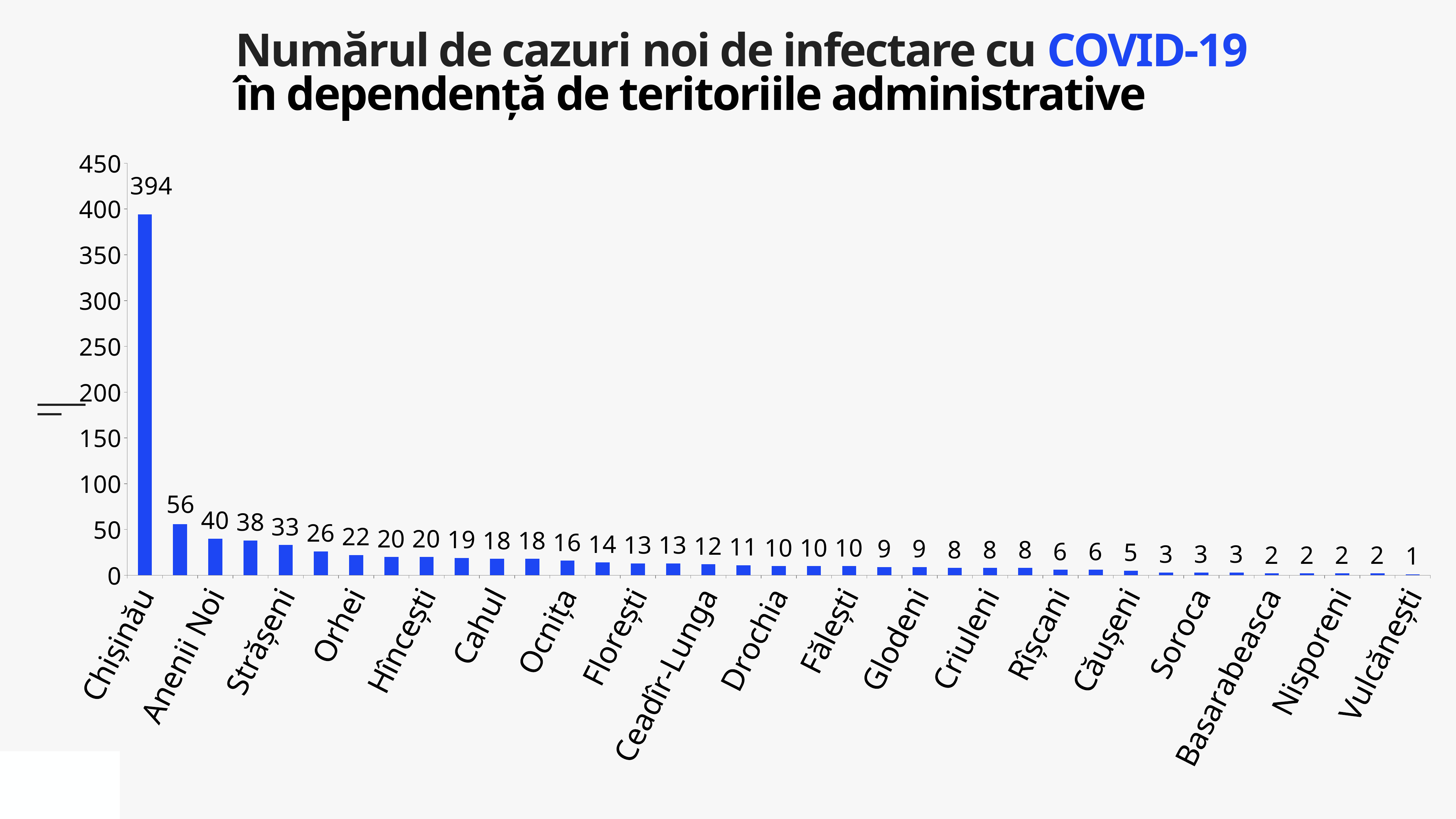
What is the difference between the values for Chișinău and Anenii Noi? 354 How many new cases are shown for Orhei? 22 Which territory has the lowest number of new cases? Vulcănești Is the value for Chișinău greater or less than 350? greater What colour are the bars in the chart? blue Which has more new cases, Orhei or Cahul? Orhei What type of chart is shown on the slide? bar chart Which territory has the highest number of new COVID-19 cases? Chișinău Do the values rise or fall from left to right along the x axis? fall How many new cases are shown for Chișinău? 394 How many new cases are shown for Anenii Noi? 40 How many new cases are shown for Vulcănești? 1